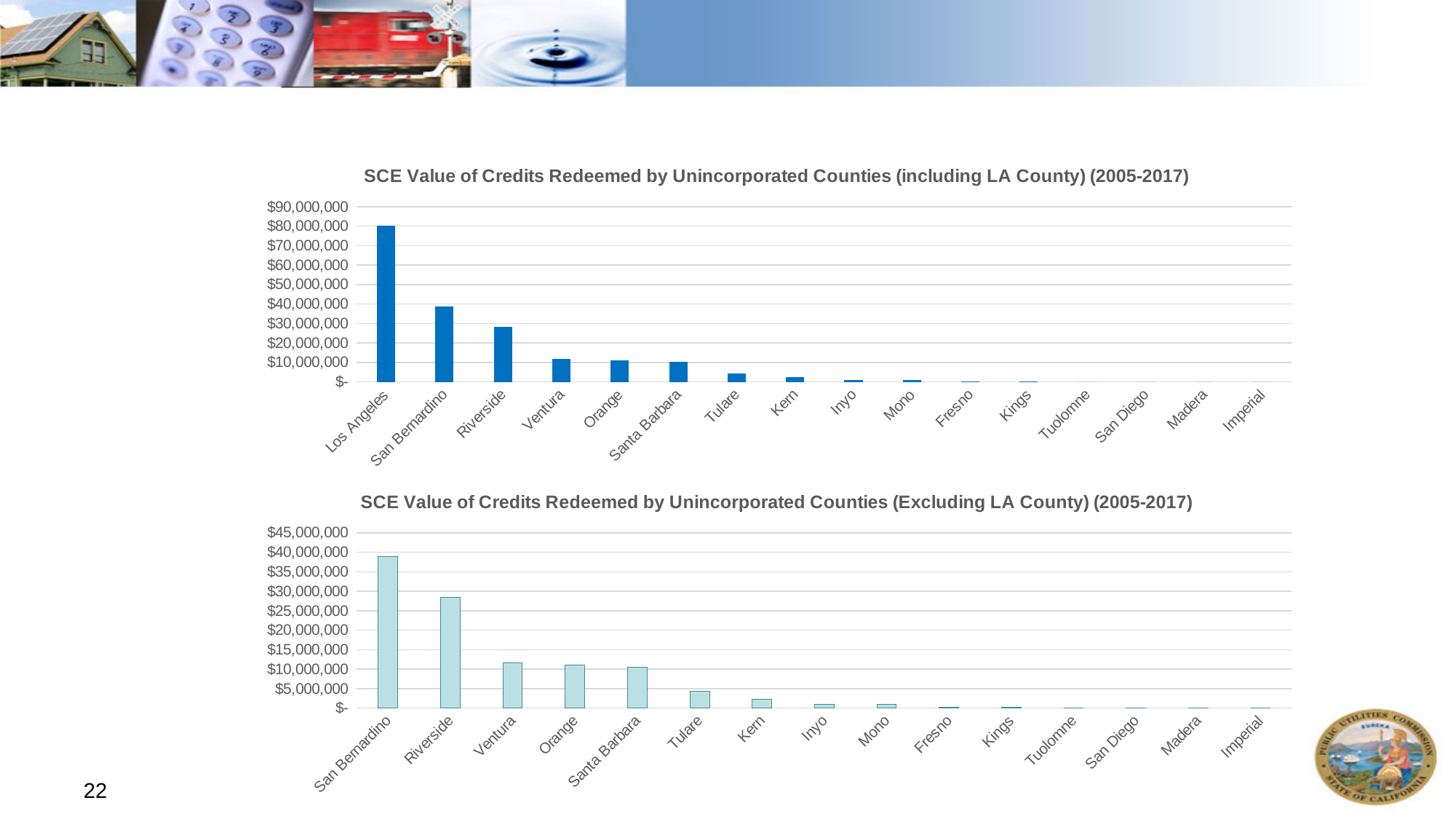
How many counties are shown on the x axis of the bottom chart (Excluding LA County)? 15 What kind of chart is the top chart, 'SCE Value of Credits Redeemed by Unincorporated Counties (including LA County) (2005-2017)'? Bar chart In the bottom chart (Excluding LA County), which county has the larger value: Riverside or Ventura? Riverside In the top chart (including LA County), which county has the highest value of credits redeemed? Los Angeles In the bottom chart (Excluding LA County), which county has the highest value of credits redeemed? San Bernardino In the bottom chart (Excluding LA County), do the values generally rise or fall moving from left to right along the x axis? Fall In the top chart (including LA County), is the value for Los Angeles greater or less than $70,000,000? greater In the bottom chart (Excluding LA County), is the value for Riverside greater or less than $30,000,000? less In the top chart (including LA County), is the value for Tulare greater or less than $10,000,000? less How many counties are shown on the x axis of the top chart (including LA County)? 16